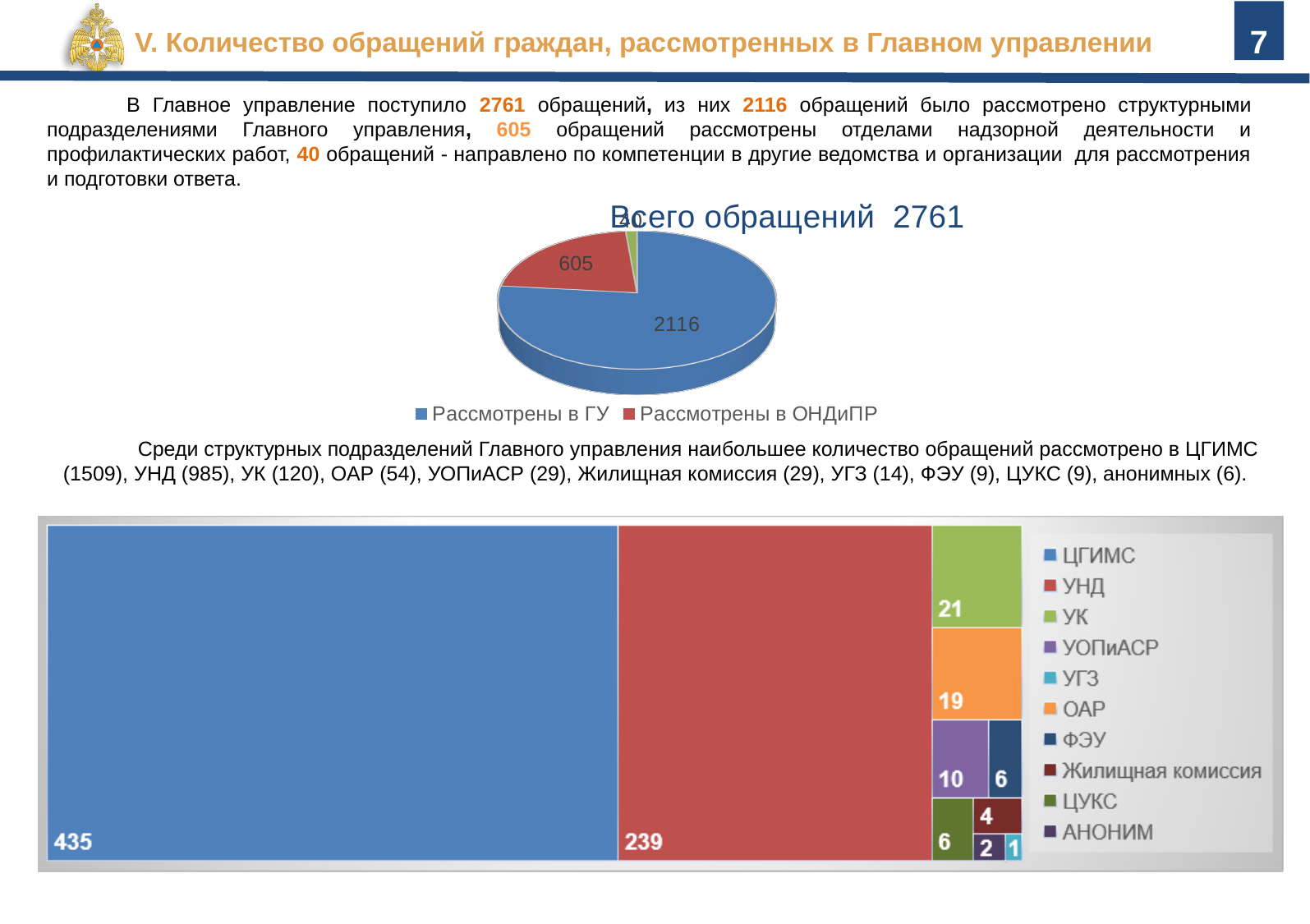
In the pie chart titled 'Всего обращений 2761', what value is shown for the 'Рассмотрены в ГУ' slice? 2116 In the pie chart titled 'Всего обращений 2761', what value is shown for the 'Рассмотрены в ОНДиПР' slice? 605 In the lower chart, which category has the largest value? ЦГИМС In the lower chart, what value is shown for ЦГИМС (the blue area)? 435 In the lower chart, what value is shown for УНД (the red area)? 239 What kind of chart is the upper chart titled 'Всего обращений 2761'? pie chart In the pie chart titled 'Всего обращений 2761', what is the difference between the 'Рассмотрены в ГУ' and 'Рассмотрены в ОНДиПР' values? 1511 In the lower chart, what value is shown for УК (the green area)? 21 In the pie chart titled 'Всего обращений 2761', which legend entry corresponds to the largest slice? Рассмотрены в ГУ How many categories does the legend of the lower chart list? 10 In the lower chart, what is the difference between the values for ЦГИМС and УНД? 196 How many entries does the legend of the pie chart titled 'Всего обращений 2761' list? 2